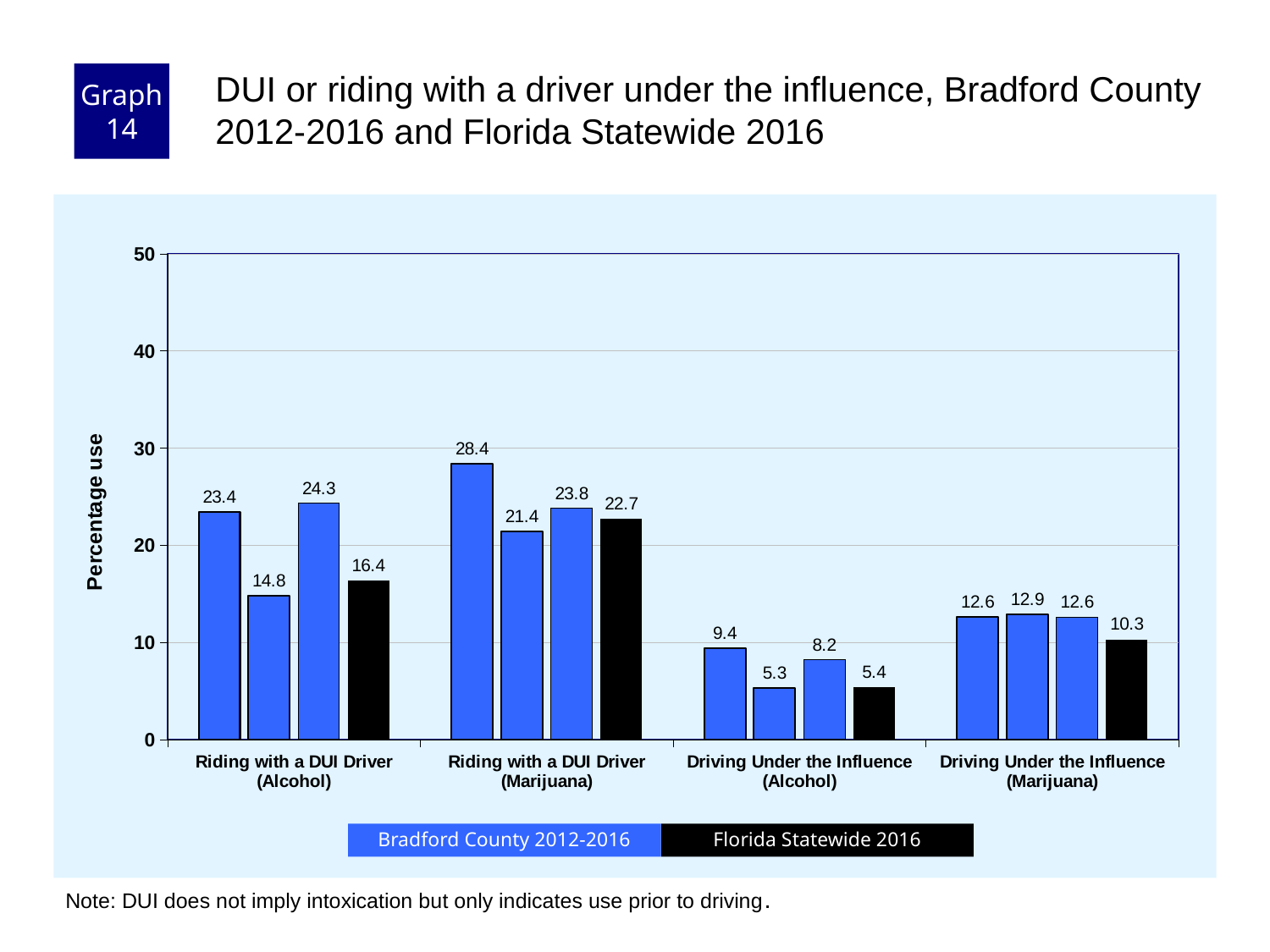
How many categories are shown on the x axis? 4 What is the lowest value shown for any Bradford County 2012-2016 bar in the Driving Under the Influence (Alcohol) category? 5.3 How many series does the legend list? 2 What is the Florida Statewide 2016 value for Riding with a DUI Driver (Marijuana)? 22.7 What kind of chart is shown on the slide? bar chart Is the Florida Statewide 2016 value for Riding with a DUI Driver (Marijuana) greater or less than 20? greater What is the difference between the Florida Statewide 2016 values for Riding with a DUI Driver (Marijuana) and Riding with a DUI Driver (Alcohol)? 6.3 What is the highest value shown for any Bradford County 2012-2016 bar in the Riding with a DUI Driver (Marijuana) category? 28.4 What is the Florida Statewide 2016 value for Driving Under the Influence (Marijuana)? 10.3 Which is larger: the Florida Statewide 2016 value for Driving Under the Influence (Alcohol) or for Driving Under the Influence (Marijuana)? Driving Under the Influence (Marijuana) What is the Florida Statewide 2016 value for Riding with a DUI Driver (Alcohol)? 16.4 What is the label of the y axis? Percentage use